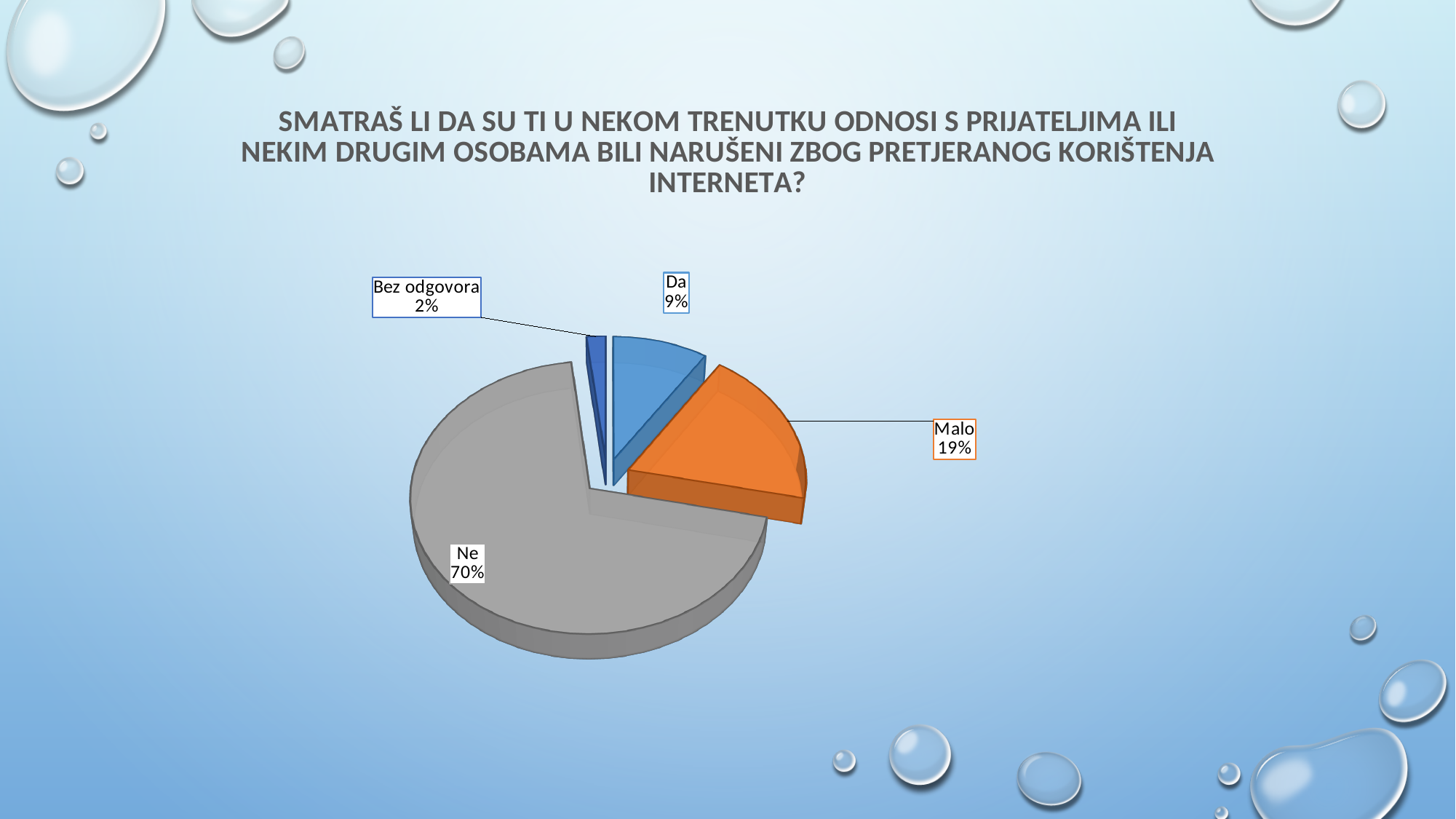
Which slice is larger, "Da" or "Malo"? Malo What share of the pie does the "Ne" slice represent? 70% How many slices does the pie chart have? 4 What is the difference in percentage points between the "Da" and "Bez odgovora" slices? 7 What kind of chart is shown on the slide? pie chart What share of the pie does the "Da" slice represent? 9% Which category has the largest slice of the pie? Ne What share of the pie does the "Bez odgovora" slice represent? 2% What is the difference in percentage points between the "Ne" and "Malo" slices? 51 What colour is the "Malo" slice of the pie? orange Which category has the smallest slice of the pie? Bez odgovora